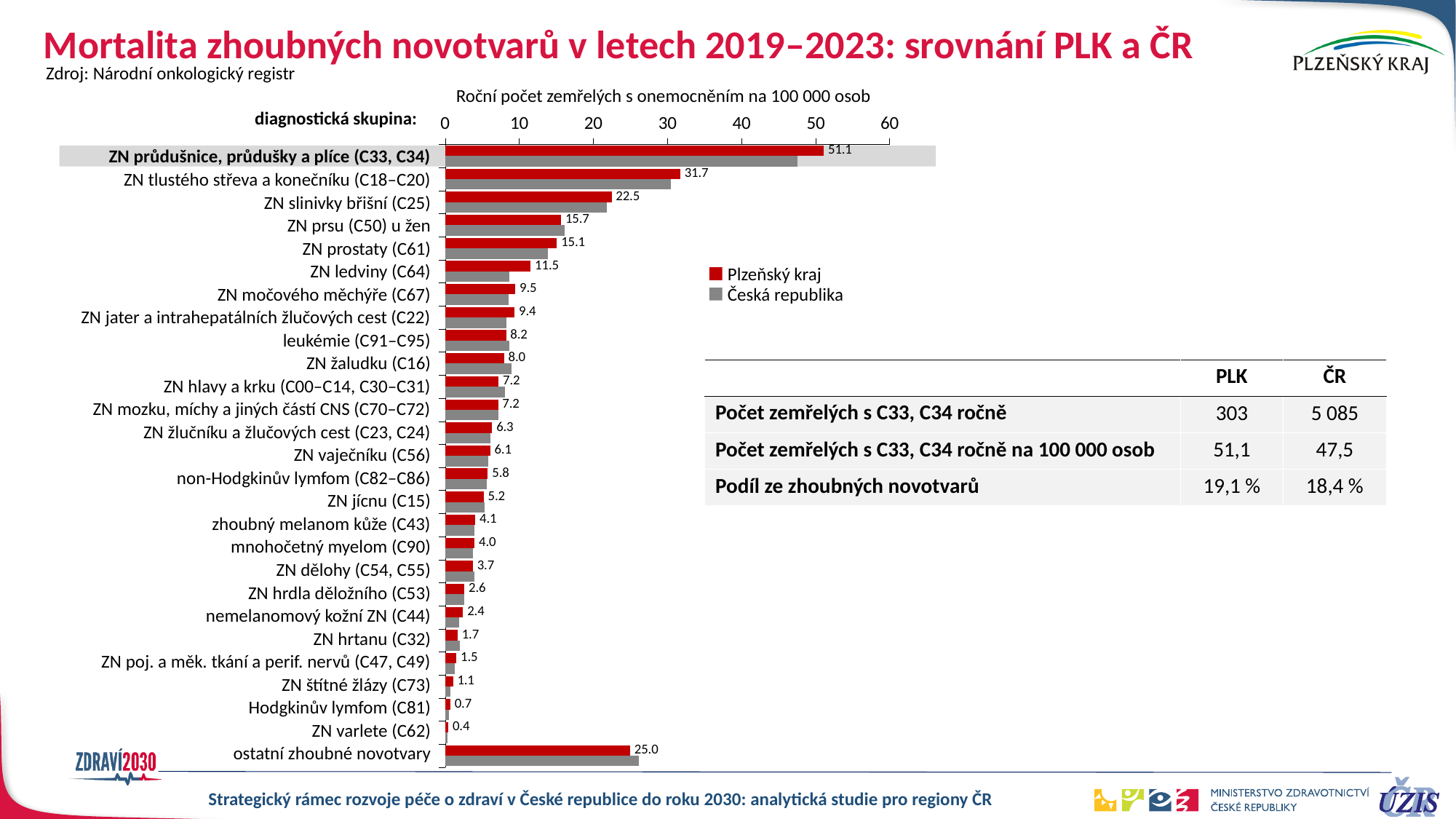
What is the value for Plzeňský kraj for ZN prostaty (C61)? 15.1 What is the value for Plzeňský kraj for ZN průdušnice, průdušky a plíce (C33, C34)? 51.1 What is the value for Plzeňský kraj for ostatní zhoubné novotvary? 25.0 How many series does the legend list? 2 What is the difference between the Plzeňský kraj values for ZN průdušnice, průdušky a plíce (C33, C34) and ZN tlustého střeva a konečníku (C18–C20)? 19.4 What is the value for Plzeňský kraj for ZN slinivky břišní (C25)? 22.5 What kind of chart is shown on the slide? bar chart Which diagnostic group has the lowest value for Plzeňský kraj? ZN varlete (C62) Which is larger for Plzeňský kraj: ZN ledviny (C64) or ZN močového měchýře (C67)? ZN ledviny (C64) Which diagnostic group has the highest value for Plzeňský kraj? ZN průdušnice, průdušky a plíce (C33, C34) Is the Česká republika value for ZN průdušnice, průdušky a plíce (C33, C34) greater or less than 40? greater How many diagnostic groups are shown on the chart? 27